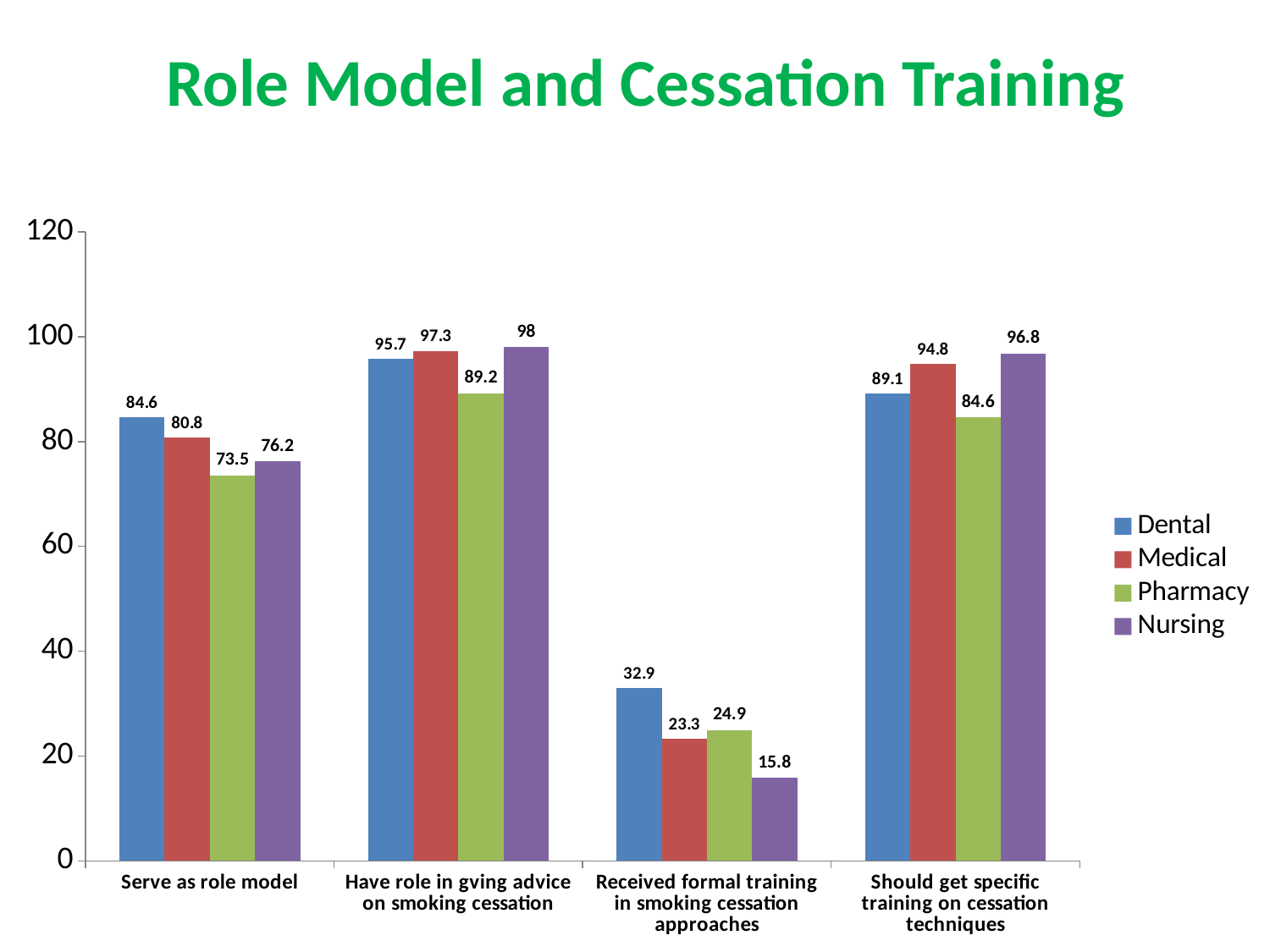
What is the title of the slide? Role Model and Cessation Training Which is larger in the 'Have role in gving advice on smoking cessation' category: Medical or Pharmacy? Medical What is the value for Dental in the 'Serve as role model' category? 84.6 Is the value for Dental in the 'Received formal training in smoking cessation approaches' category greater or less than 40? less How many categories are shown on the x axis? 4 What is the difference between the Dental and Pharmacy values in the 'Serve as role model' category? 11.1 Which series has the lowest value in the 'Received formal training in smoking cessation approaches' category? Nursing Which series has the highest value in the 'Should get specific training on cessation techniques' category? Nursing What is the value for Medical in the 'Received formal training in smoking cessation approaches' category? 23.3 How many series does the legend list? 4 What is the value for Nursing in the 'Have role in gving advice on smoking cessation' category? 98 What kind of chart is shown on the slide? bar chart